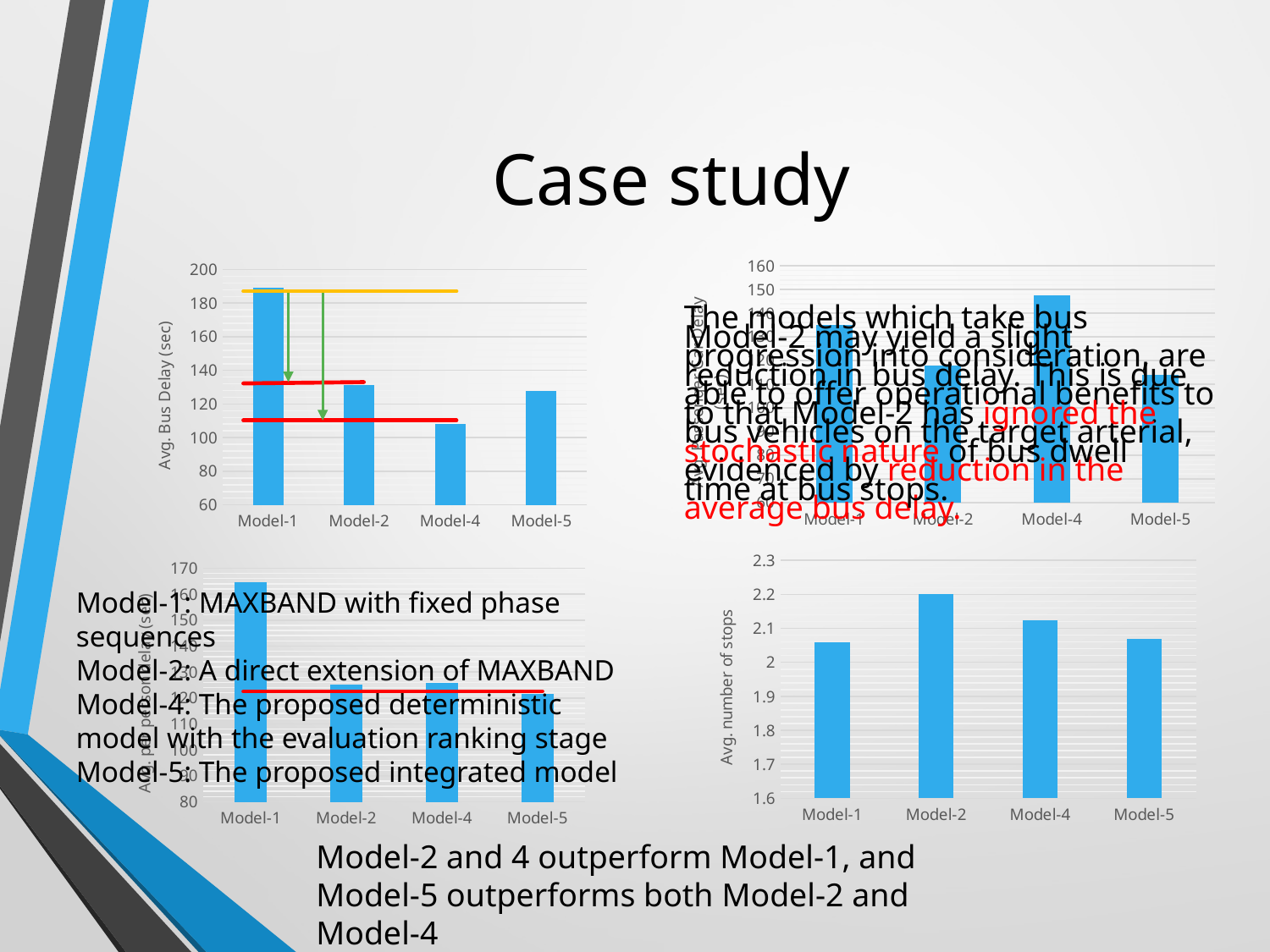
In the top-left chart (Avg. Bus Delay), which model has the highest average bus delay? Model-1 What kind of chart is the top-left chart (Avg. Bus Delay)? bar chart In the bottom-left chart (Avg. person delay), is the value for Model-1 greater or less than 150? greater In the top-left chart (Avg. Bus Delay), which is larger, the value for Model-1 or Model-5? Model-1 What is the y-axis title of the top-left chart? Avg. Bus Delay (sec) In the top-left chart (Avg. Bus Delay), which model has the lowest average bus delay? Model-4 In the bottom-left chart (Avg. person delay), which model has the highest average person delay? Model-1 How many models are plotted in the top-left chart (Avg. Bus Delay)? 4 In the bottom-right chart (Avg. number of stops), which model has the highest average number of stops? Model-2 In the bottom-right chart (Avg. number of stops), is the value for Model-1 greater or less than 2.1? less In the top-left chart (Avg. Bus Delay), is the value for Model-4 greater or less than 120? less